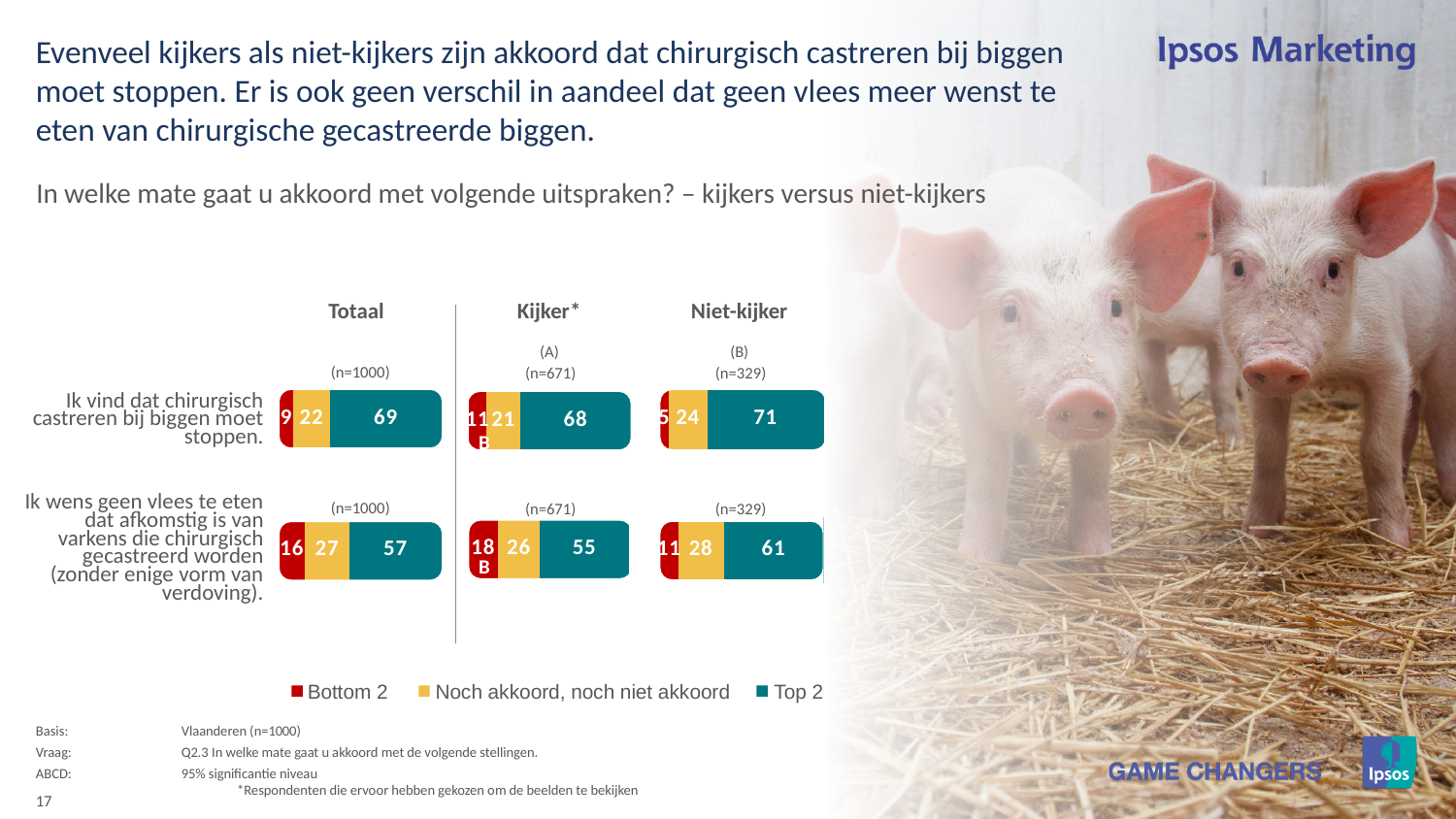
In the Totaal chart, what is the total of the stacked bar for the statement about not wanting to eat meat from surgically castrated pigs? 100 Across the three charts, which group has the highest Top 2 value for the statement 'Ik vind dat chirurgisch castreren bij biggen moet stoppen'? Niet-kijker Across the three charts, which group has the lowest Bottom 2 value for the statement 'Ik vind dat chirurgisch castreren bij biggen moet stoppen'? Niet-kijker What is the difference between the Top 2 values of Niet-kijker and Kijker for the statement about not wanting to eat meat from surgically castrated pigs? 6 In the Niet-kijker chart, what is the Top 2 value for the statement about not wanting to eat meat from surgically castrated pigs? 61 For the statement 'Ik vind dat chirurgisch castreren bij biggen moet stoppen', is the Bottom 2 value larger for Kijker or for Niet-kijker? Kijker What kind of chart is used on this slide? Stacked bar chart In the Niet-kijker chart, what is the 'Noch akkoord, noch niet akkoord' value for the statement 'Ik vind dat chirurgisch castreren bij biggen moet stoppen'? 24 What is the sample size (n) shown for the Kijker group? n=671 How many series does the legend list? 3 In the Totaal chart, what is the Top 2 value for the statement 'Ik vind dat chirurgisch castreren bij biggen moet stoppen'? 69 In the Kijker chart, what is the Bottom 2 value for the statement 'Ik wens geen vlees te eten dat afkomstig is van varkens die chirurgisch gecastreerd worden'? 18